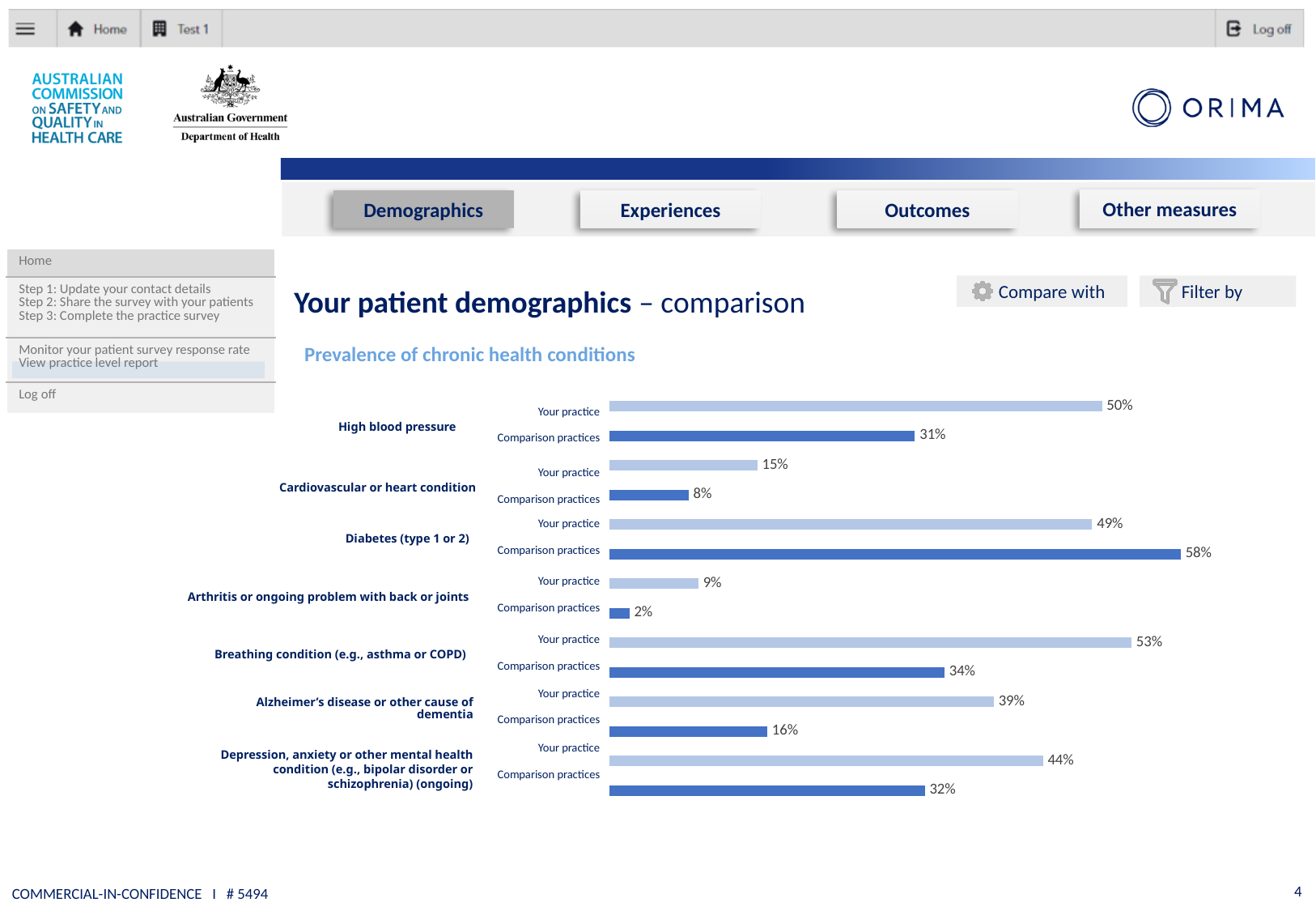
What is the 'Your practice' value for Alzheimer's disease or other cause of dementia? 39% What is the 'Comparison practices' value for Arthritis or ongoing problem with back or joints? 2% How many chronic health conditions are shown in the chart? 7 Which condition has the highest 'Your practice' value? Breathing condition (e.g., asthma or COPD) For Depression, anxiety or other mental health condition, which is larger: 'Your practice' or 'Comparison practices'? Your practice What is the 'Your practice' value for High blood pressure? 50% What is the difference between the 'Your practice' and 'Comparison practices' values for High blood pressure? 19% What is the difference between the 'Comparison practices' and 'Your practice' values for Diabetes (type 1 or 2)? 9% What is the title of the chart? Prevalence of chronic health conditions What type of chart is used to show the prevalence of chronic health conditions? Bar chart Which condition has the lowest 'Comparison practices' value? Arthritis or ongoing problem with back or joints What is the 'Comparison practices' value for Diabetes (type 1 or 2)? 58%